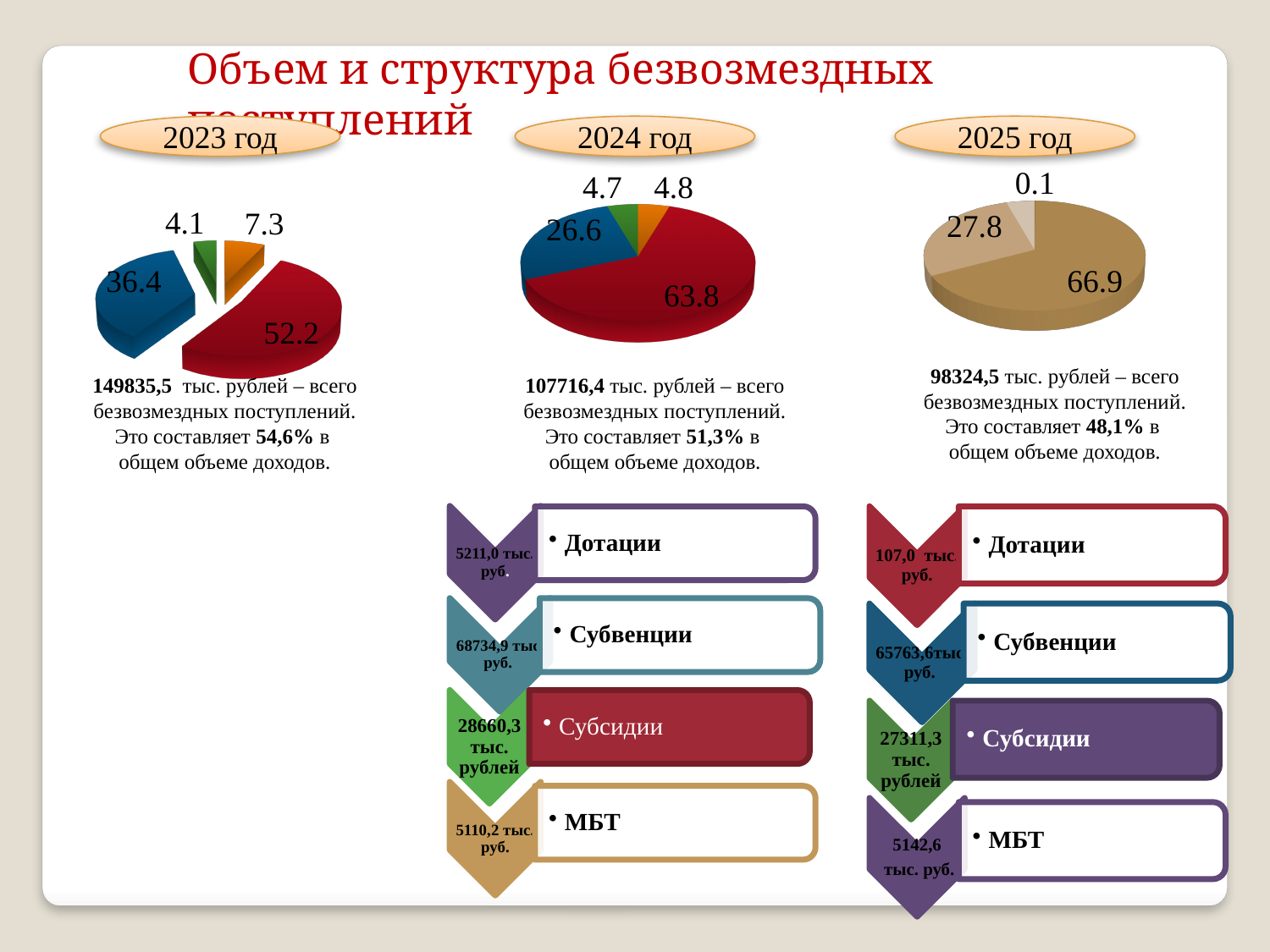
In the '2023 год' pie chart, what is the smallest value shown? 4.1 How many data labels are shown on the '2023 год' pie chart? 4 How many pie charts are shown on the slide? 3 What kind of chart is shown under the heading '2023 год'? pie chart In the '2024 год' pie chart, what is the smallest value shown? 4.7 Which pie chart has the larger biggest slice, '2023 год' or '2024 год'? 2024 год In the '2024 год' pie chart, what is the difference between the two largest values, 63.8 and 26.6? 37.2 In the '2023 год' pie chart, what is the largest value shown? 52.2 In the '2024 год' pie chart, what is the largest value shown? 63.8 In the '2025 год' pie chart, what is the smallest value shown? 0.1 In the '2025 год' pie chart, what is the largest value shown? 66.9 In the '2023 год' pie chart, what is the difference between the two largest values, 52.2 and 36.4? 15.8